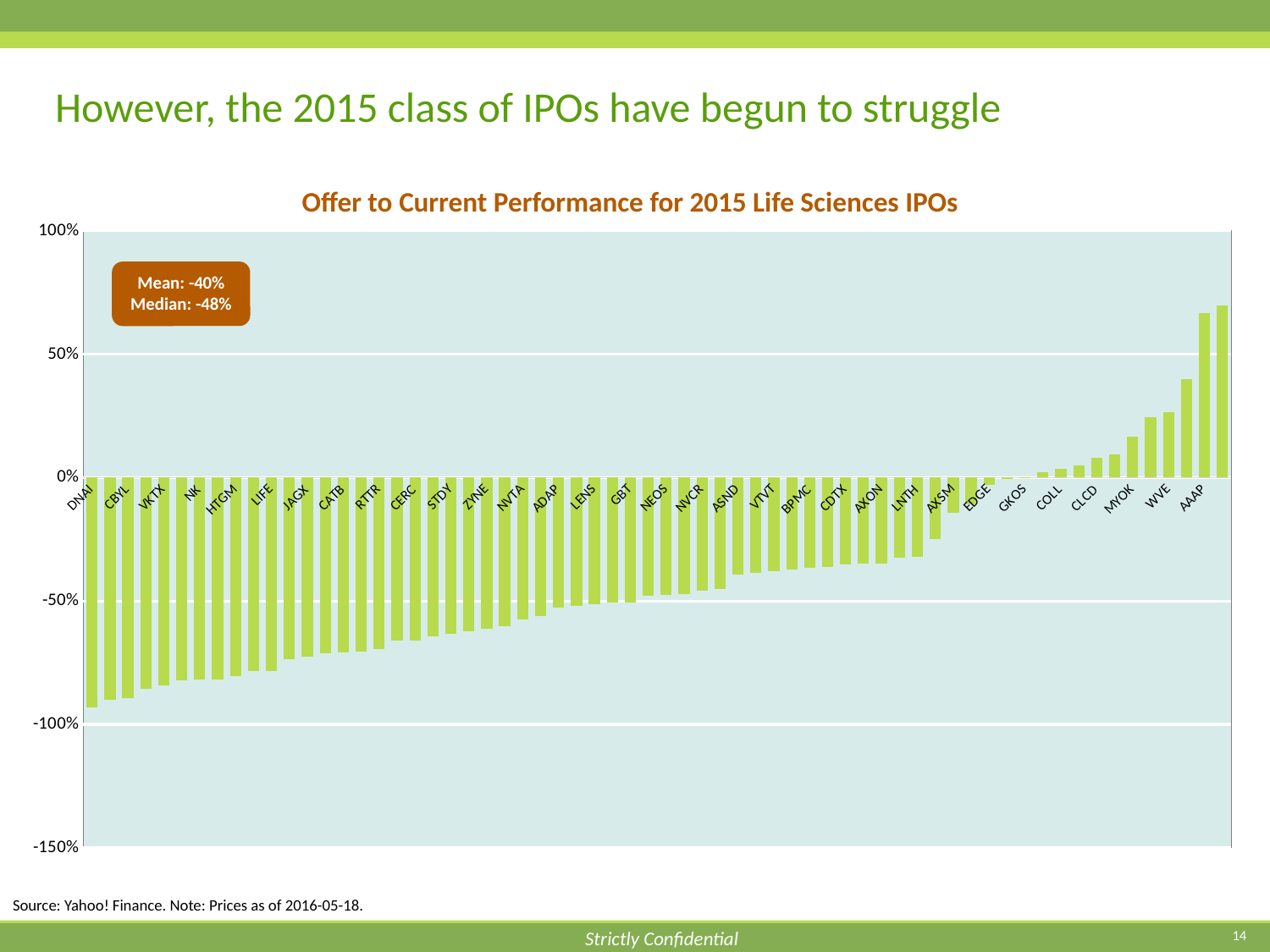
What is the title of the chart? Offer to Current Performance for 2015 Life Sciences IPOs Which labelled company has the lowest offer-to-current performance? DNAI Which has the larger value, CBYL or WVE? WVE Which has the larger value, DNAI or AAAP? AAAP Do the values rise or fall moving from left to right along the x axis? Rise Is the value for BPMC greater or less than -50%? greater What kind of chart is shown on the slide? Bar chart Is the value for DNAI greater or less than -50%? less Is the value for NVTA greater or less than -50%? less What mean value is printed in the box on the chart? -40%